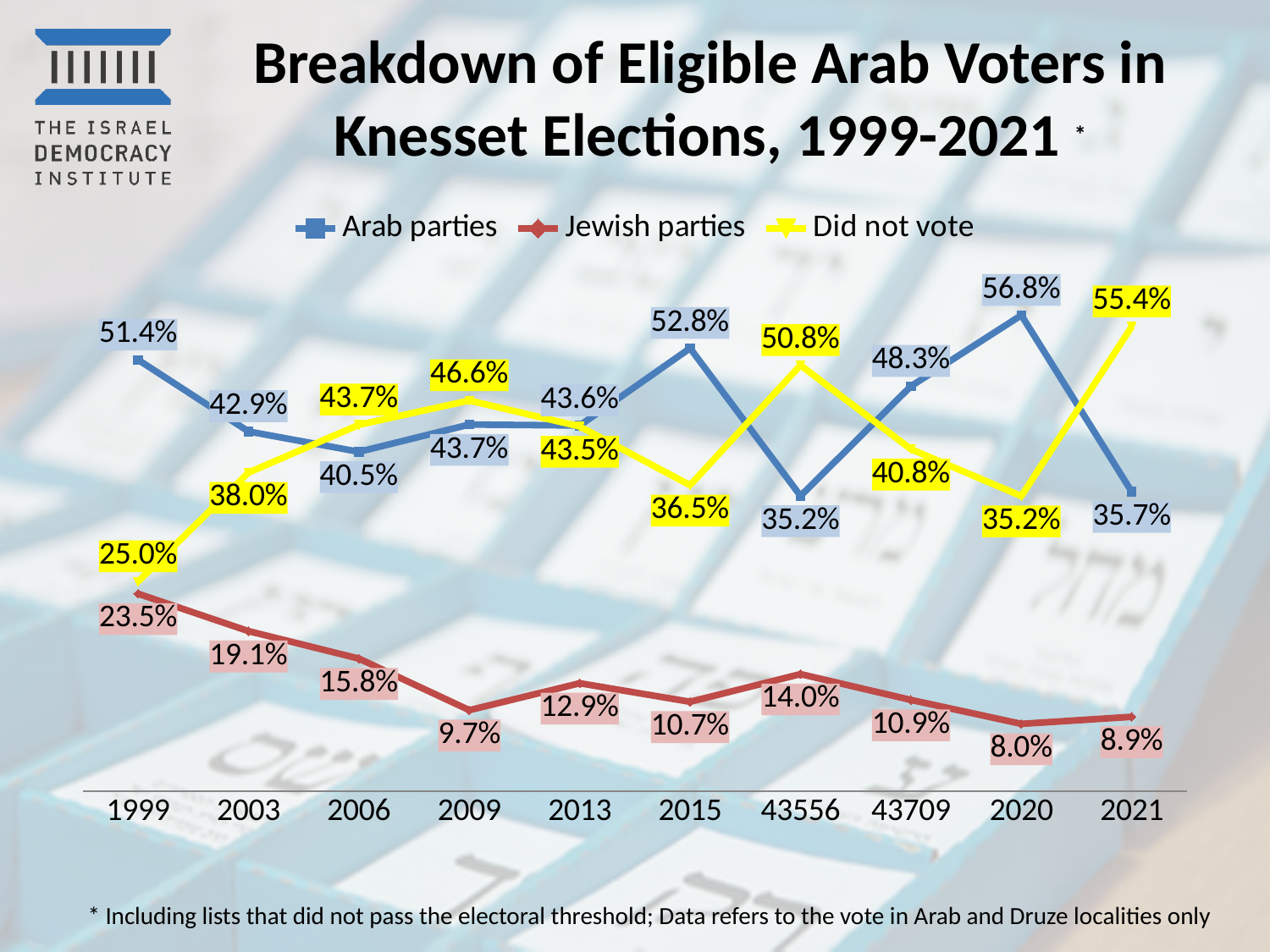
What is the value for Arab parties in 1999? 51.4% How many series does the legend list? 3 In which year does the Arab parties series reach its highest value? 2020 What is the difference between the Arab parties value in 2020 and in 2021? 21.1% How many points are plotted along the x axis for each series? 10 Which colour is used for the Did not vote series? yellow Does the Jewish parties series generally rise or fall from 1999 to 2021? fall What is the value for Jewish parties in 2009? 9.7% In 2015, which is larger: the Arab parties value or the Did not vote value? Arab parties What type of chart is shown on the slide? line chart In which year does the Jewish parties series reach its lowest value? 2020 What is the value for Did not vote in 2021? 55.4%